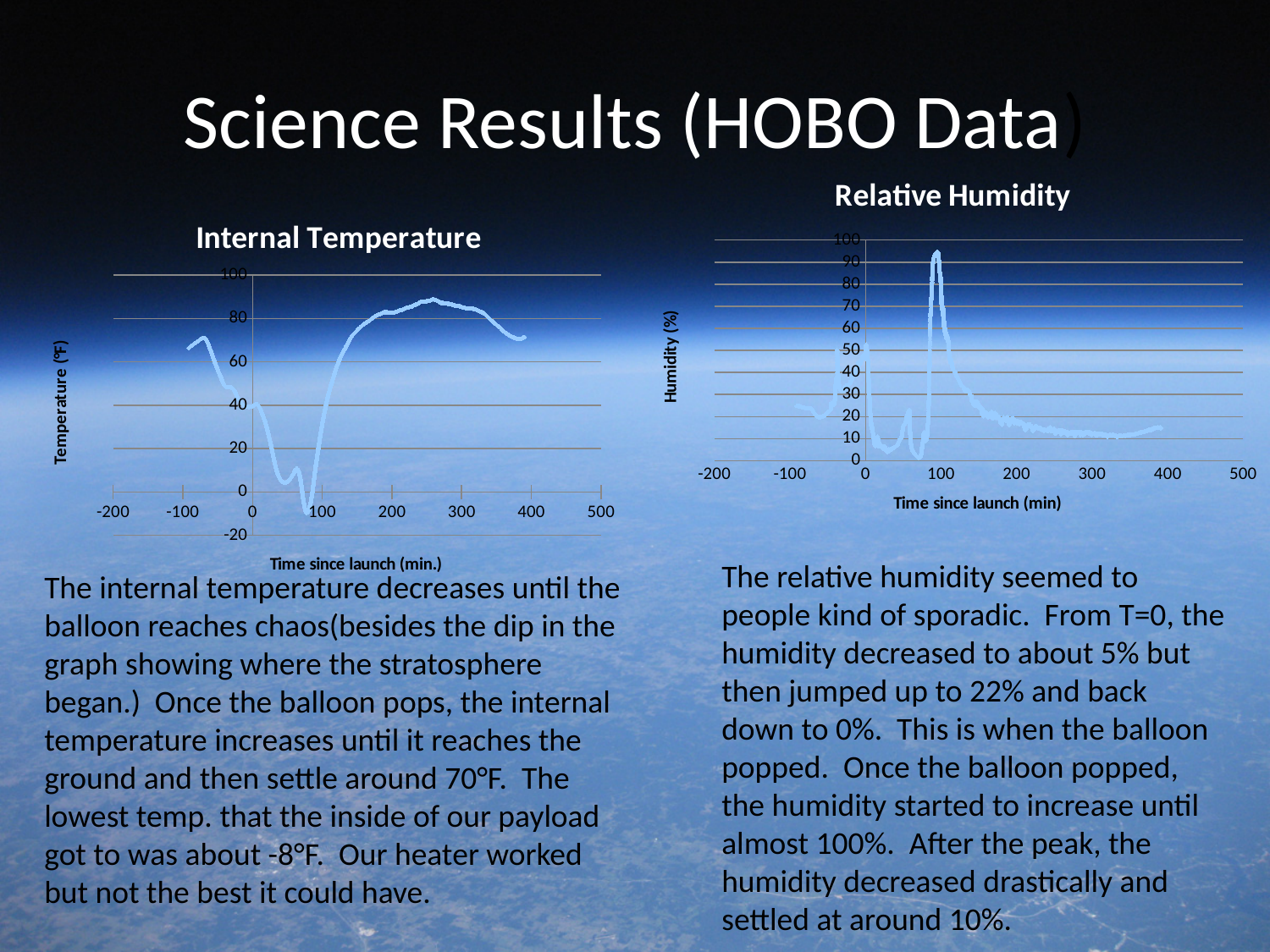
On the Relative Humidity chart, does the line rise or fall between 100 and 300 minutes since launch? fall On the Internal Temperature chart, is the highest value of the line greater or less than 100? less On the Internal Temperature chart, is the value at 300 minutes since launch greater or less than 60? greater On the Relative Humidity chart, is the peak value of the line greater or less than 80? greater What kind of chart is the Internal Temperature chart? line chart On the Internal Temperature chart, does the line rise or fall between 100 and 250 minutes since launch? rise On the Relative Humidity chart, what is the label of the x axis? Time since launch (min) On the Internal Temperature chart, what is the label of the y axis? Temperature (°F) What kind of chart is the Relative Humidity chart? line chart